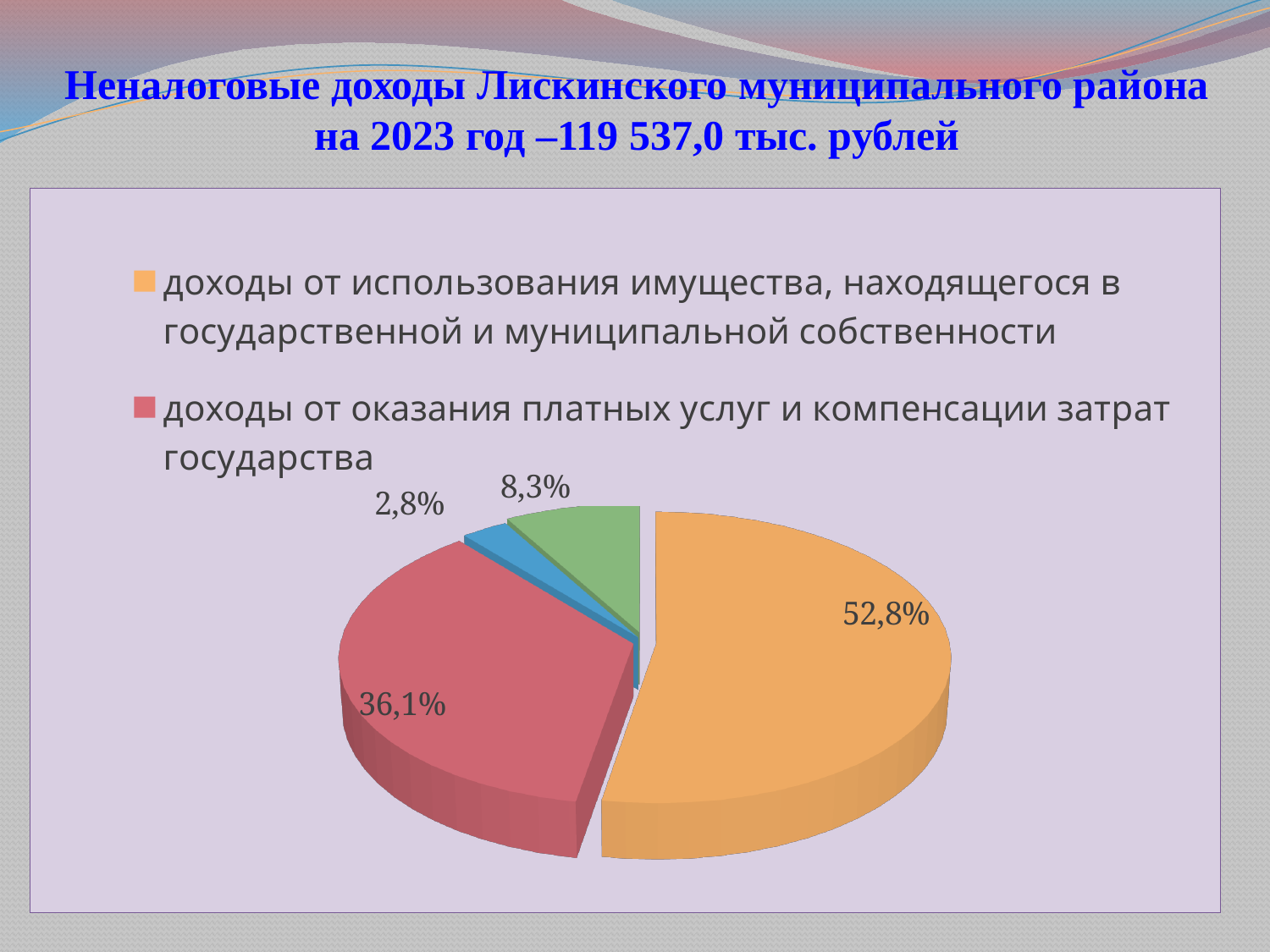
Which is larger: the slice for доходы от использования имущества or the slice for доходы от оказания платных услуг? доходы от использования имущества What is the difference in percentage points between the slice for доходы от использования имущества and the slice for доходы от оказания платных услуг? 16,7 What total amount of non-tax revenue for 2023 is stated in the slide title? 119 537,0 тыс. рублей What colour is the slice for доходы от оказания платных услуг и компенсации затрат государства? red How many entries does the legend list? 2 What share of the pie is taken by доходы от использования имущества, находящегося в государственной и муниципальной собственности? 52,8% How many slices does the pie chart have? 4 Which legend category has the largest slice of the pie? доходы от использования имущества, находящегося в государственной и муниципальной собственности What kind of chart is shown on the slide? pie chart What is the largest percentage shown on the pie chart? 52,8% What share of the pie is taken by доходы от оказания платных услуг и компенсации затрат государства? 36,1% What is the smallest percentage shown on the pie chart? 2,8%